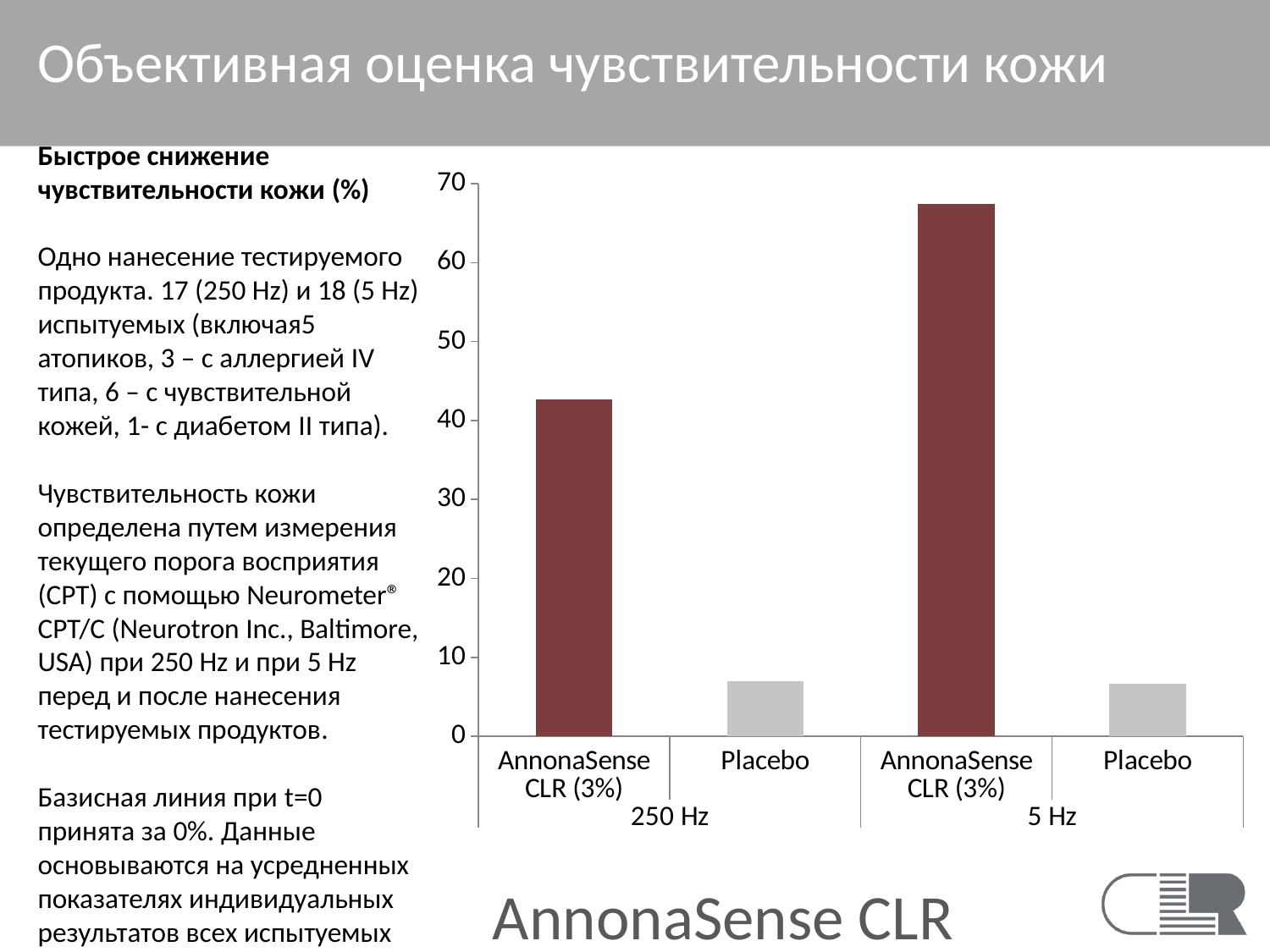
How many bars are plotted in the chart? 4 What kind of chart is shown on the slide? bar chart What is the highest tick value shown on the vertical axis of the chart? 70 Is the value for Placebo at 5 Hz greater or less than 10? less Which is larger: AnnonaSense CLR (3%) at 250 Hz or AnnonaSense CLR (3%) at 5 Hz? AnnonaSense CLR (3%) at 5 Hz Which bar has the highest value in the chart? AnnonaSense CLR (3%) at 5 Hz Is the value for AnnonaSense CLR (3%) at 5 Hz greater or less than 60? greater How many frequency groups are shown on the x axis of the chart? 2 Is the value for Placebo at 250 Hz greater or less than 10? less What colour are the AnnonaSense CLR (3%) bars in the chart? dark red Which is larger at 250 Hz: AnnonaSense CLR (3%) or Placebo? AnnonaSense CLR (3%)